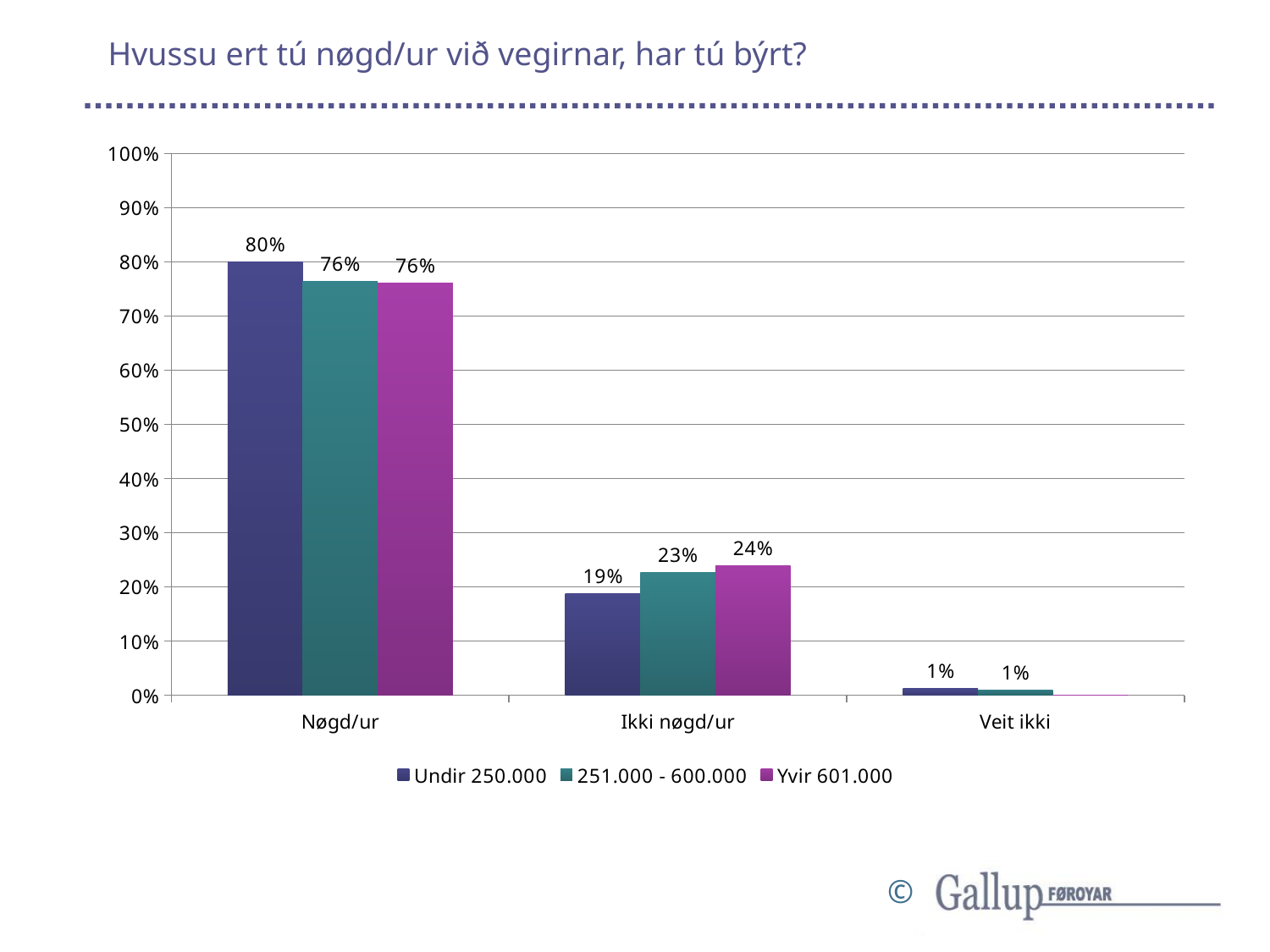
Which series has the lowest value in the Ikki nøgd/ur category? Undir 250.000 Which category has the highest value for the Undir 250.000 series? Nøgd/ur How many categories are shown on the x axis? 3 What is the value for Undir 250.000 in the Nøgd/ur category? 80% What is the title of the slide? Hvussu ert tú nøgd/ur við vegirnar, har tú býrt? What is the value for 251.000 - 600.000 in the Ikki nøgd/ur category? 23% What is the value for Undir 250.000 in the Veit ikki category? 1% What kind of chart is shown on the slide? bar chart How many series does the legend list? 3 What is the difference between the Undir 250.000 and Yvir 601.000 values in the Nøgd/ur category? 4% What is the value for Yvir 601.000 in the Ikki nøgd/ur category? 24% Which is larger in the Ikki nøgd/ur category: Undir 250.000 or 251.000 - 600.000? 251.000 - 600.000